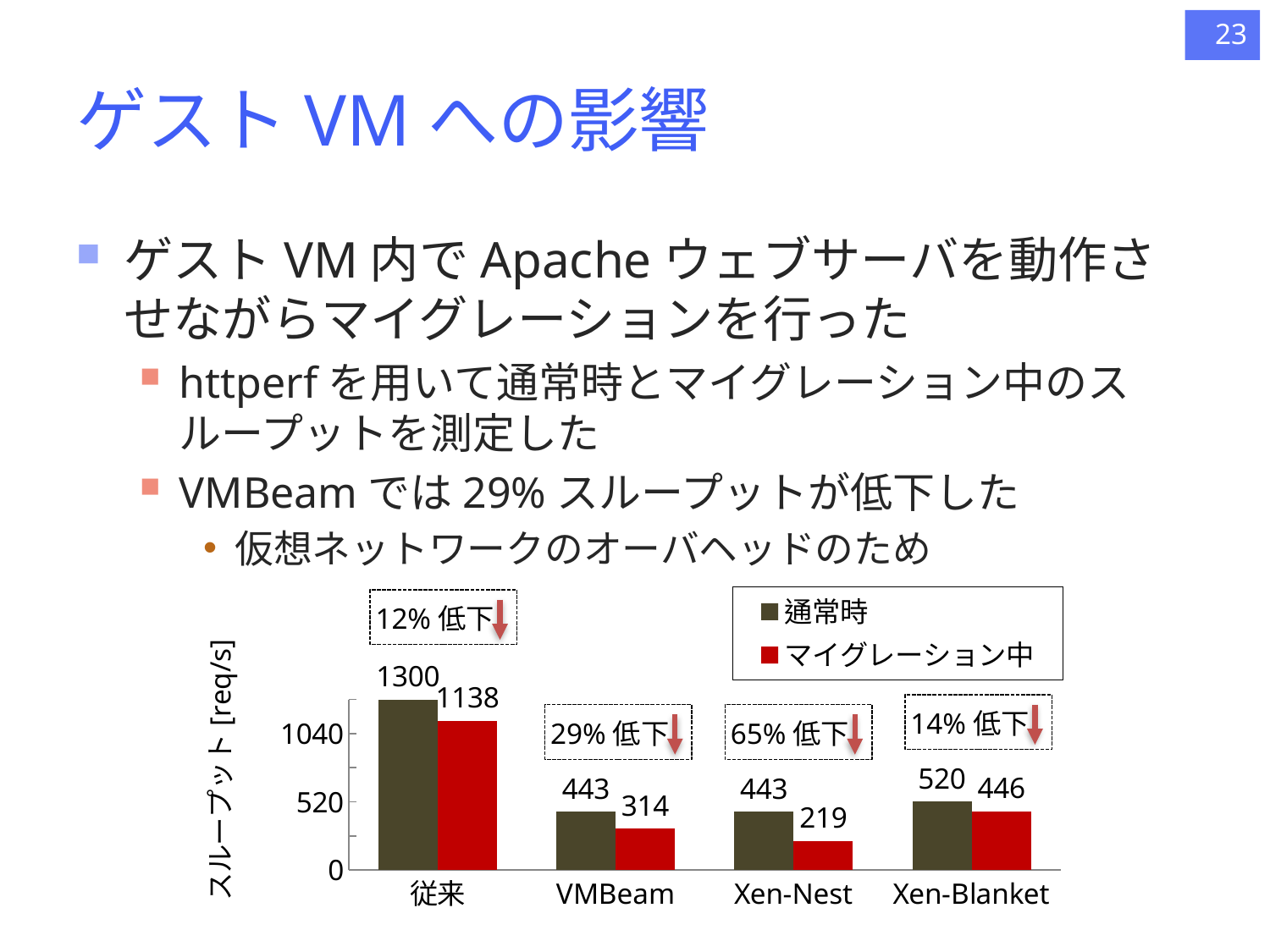
How many series does the legend list? 2 What is the 通常時 throughput for Xen-Blanket? 520 What is the difference between the 通常時 and マイグレーション中 throughput for Xen-Blanket? 74 How many categories are shown on the x axis? 4 Which category has the lowest マイグレーション中 throughput? Xen-Nest Which is larger, the マイグレーション中 throughput for VMBeam or for Xen-Blanket? Xen-Blanket What is the マイグレーション中 throughput for VMBeam? 314 Which category has the highest 通常時 throughput? 従来 What kind of chart is shown on the slide? bar chart What is the マイグレーション中 throughput for Xen-Nest? 219 What is the difference between the 通常時 and マイグレーション中 throughput for 従来? 162 What is the 通常時 throughput for 従来? 1300